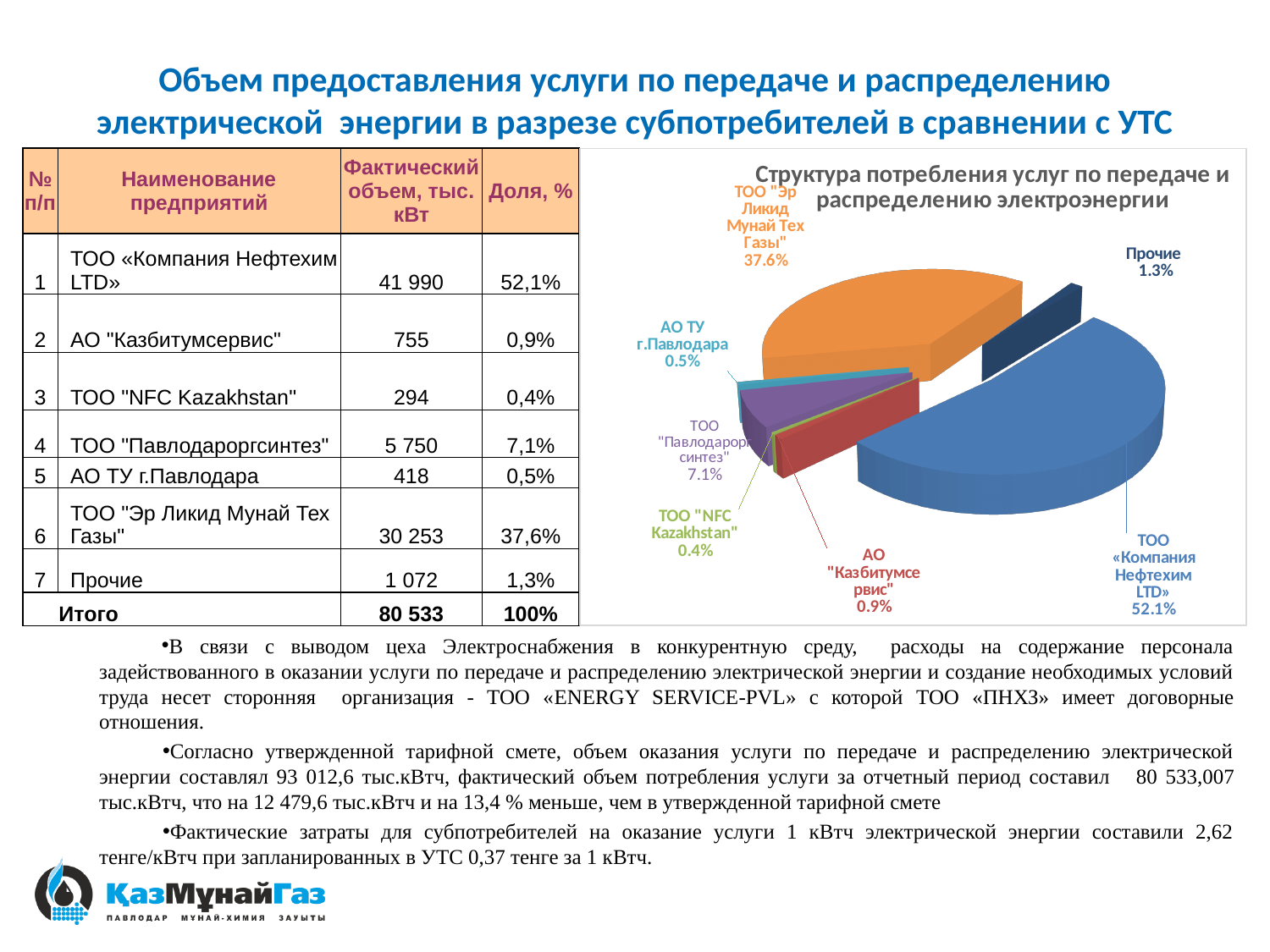
What kind of chart is shown on the slide? Pie chart Which category has the largest slice of the pie chart? ТОО «Компания Нефтехим LTD» What is the title of the pie chart? Структура потребления услуг по передаче и распределению электроэнергии What is the difference in percentage points between the slices for ТОО «Компания Нефтехим LTD» and ТОО "Эр Ликид Мунай Тех Газы"? 14.5 What percentage is shown for ТОО "Павлодароргсинтез" in the pie chart? 7.1% What percentage is shown for АО "Казбитумсервис" in the pie chart? 0.9% Which slice is larger: ТОО "Павлодароргсинтез" or Прочие? ТОО "Павлодароргсинтез" What share of the pie does ТОО "Эр Ликид Мунай Тех Газы" hold? 37.6% What percentage is shown for Прочие in the pie chart? 1.3% Which category has the smallest slice of the pie chart? ТОО "NFC Kazakhstan" What share of the pie does ТОО «Компания Нефтехим LTD» hold? 52.1% How many slices does the pie chart have? 7